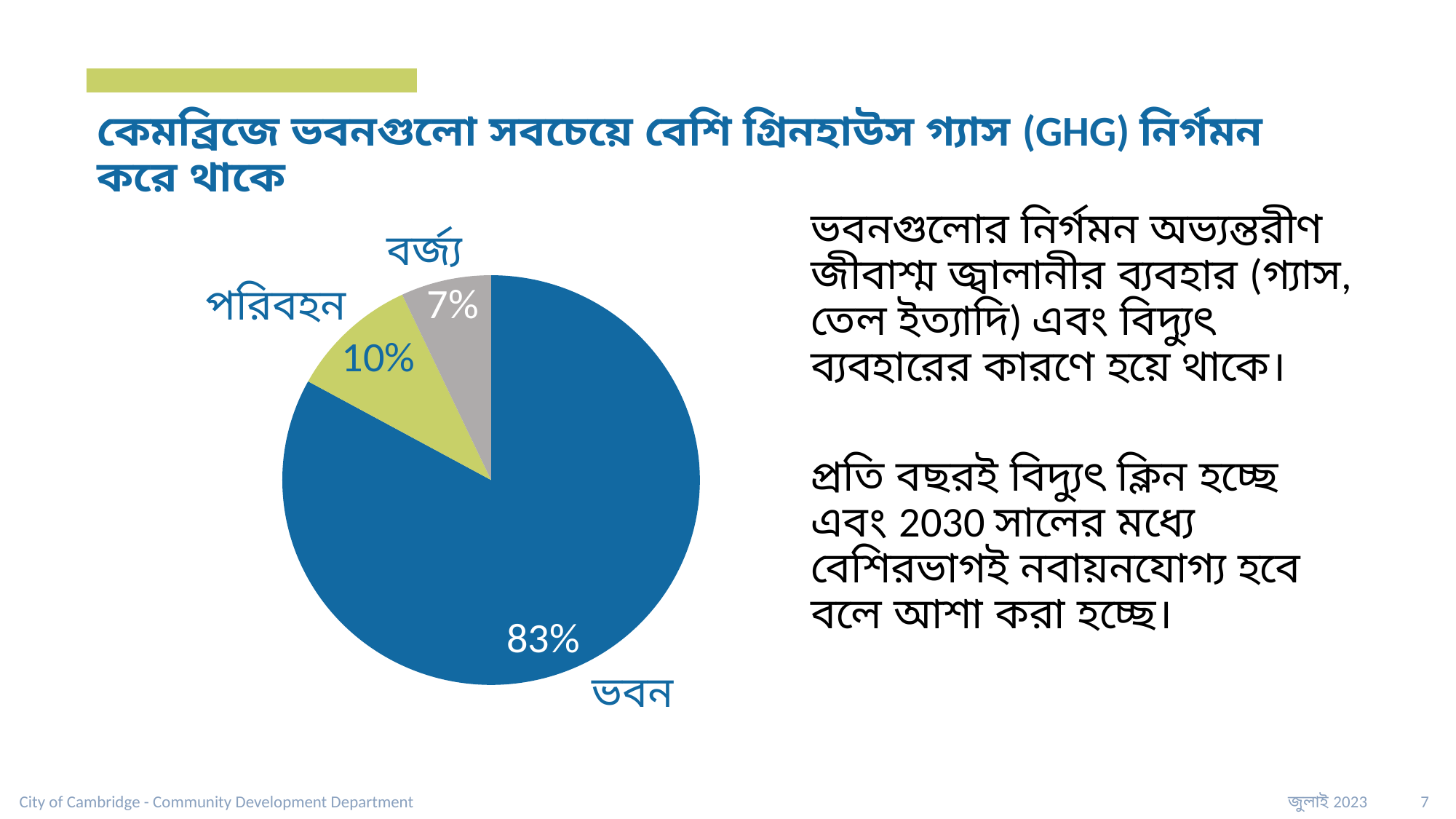
What percentage does the বর্জ্য slice show? 7% What percentage does the পরিবহন slice show? 10% How many slices does the pie chart have? 3 What is the difference in percentage points between the পরিবহন slice and the বর্জ্য slice? 3 What percentage does the ভবন slice show? 83% Which slice of the pie chart is the smallest? বর্জ্য What is the difference in percentage points between the ভবন slice and the পরিবহন slice? 73 Which is larger, the পরিবহন slice or the বর্জ্য slice? পরিবহন Which slice of the pie chart is the largest? ভবন What kind of chart is shown on the slide? pie chart What colour is the ভবন slice of the pie chart? blue What share of the pie does the ভবন slice represent? 83%